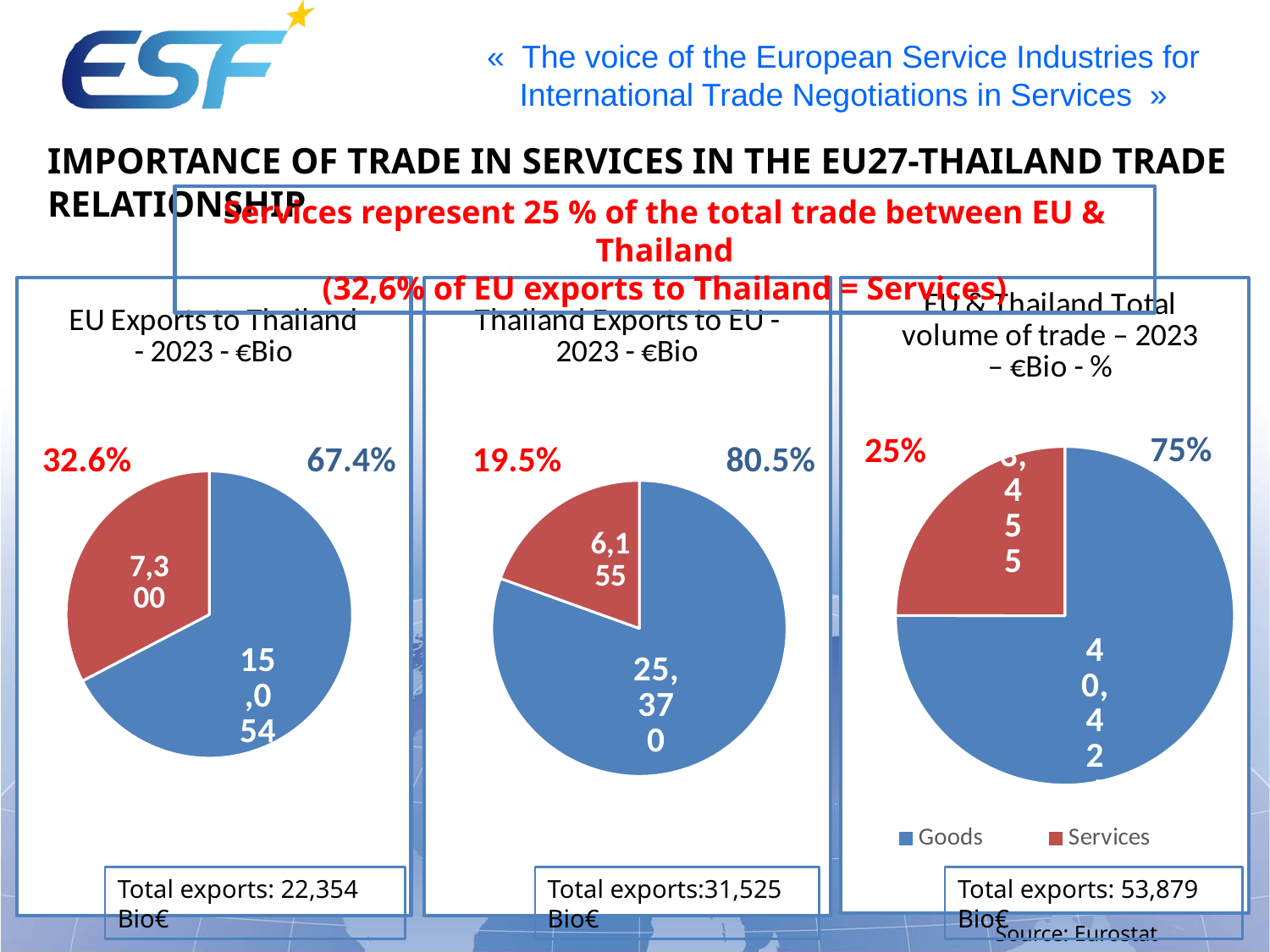
In the 'EU Exports to Thailand - 2023 - €Bio' chart, what is the value labelled on the Services slice? 7,300 In the 'EU & Thailand Total volume of trade – 2023 – €Bio - %' chart, what share of the pie is Goods? 75% In the 'Thailand Exports to EU - 2023 - €Bio' chart, what is the value labelled on the Goods slice? 25,370 In the 'Thailand Exports to EU - 2023 - €Bio' chart, which slice is larger, Goods or Services? Goods How many series does the legend on the slide list? 2 What kind of chart is used on this slide for the EU Exports to Thailand, Thailand Exports to EU, and EU & Thailand Total volume of trade figures? Pie chart In the 'Thailand Exports to EU - 2023 - €Bio' chart, what is the value labelled on the Services slice? 6,155 In the 'Thailand Exports to EU - 2023 - €Bio' chart, what share of the pie is Services? 19.5% In the 'EU Exports to Thailand - 2023 - €Bio' chart, what is the value labelled on the Goods slice? 15,054 In the 'EU Exports to Thailand - 2023 - €Bio' chart, what share of the pie is Goods? 67.4% In the 'EU Exports to Thailand - 2023 - €Bio' chart, what is the difference between the Goods value and the Services value? 7,754